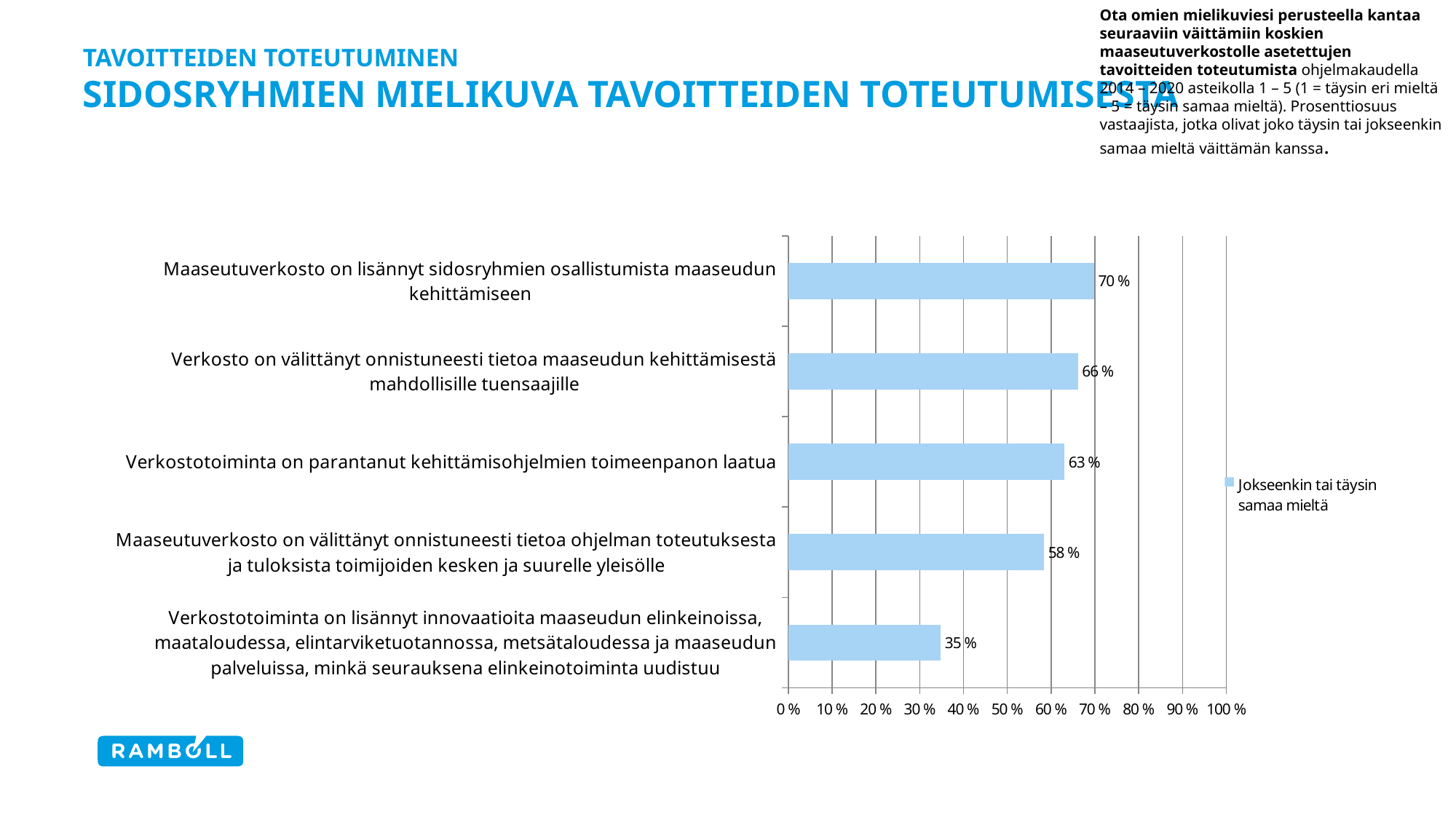
What is the legend entry for the series shown in the chart? Jokseenkin tai täysin samaa mieltä What is the difference in percentage points between the highest value (70 %) and the lowest value (35 %)? 35 percentage points What percentage of respondents agreed that "Maaseutuverkosto on lisännyt sidosryhmien osallistumista maaseudun kehittämiseen"? 70 % What is the value shown for "Verkostotoiminta on parantanut kehittämisohjelmien toimeenpanon laatua"? 63 % What kind of chart is shown on the slide? Bar chart What is the value shown for the statement about innovations in rural livelihoods ("Verkostotoiminta on lisännyt innovaatioita...")? 35 % Which statement has the lowest share of respondents agreeing? Verkostotoiminta on lisännyt innovaatioita maaseudun elinkeinoissa, maataloudessa, elintarviketuotannossa, metsätaloudessa ja maaseudun palveluissa, minkä seurauksena elinkeinotoiminta uudistuu Is the value for "Maaseutuverkosto on välittänyt onnistuneesti tietoa ohjelman toteutuksesta ja tuloksista toimijoiden kesken ja suurelle yleisölle" greater or less than 50 %? greater What is the difference between the values for "Verkosto on välittänyt onnistuneesti tietoa maaseudun kehittämisestä mahdollisille tuensaajille" and "Maaseutuverkosto on välittänyt onnistuneesti tietoa ohjelman toteutuksesta ja tuloksista toimijoiden kesken ja suurelle yleisölle"? 8 percentage points Which has a larger value: "Verkosto on välittänyt onnistuneesti tietoa maaseudun kehittämisestä mahdollisille tuensaajille" or "Verkostotoiminta on parantanut kehittämisohjelmien toimeenpanon laatua"? Verkosto on välittänyt onnistuneesti tietoa maaseudun kehittämisestä mahdollisille tuensaajille Which statement has the highest share of respondents agreeing? Maaseutuverkosto on lisännyt sidosryhmien osallistumista maaseudun kehittämiseen How many statements (bars) are shown in the chart? 5